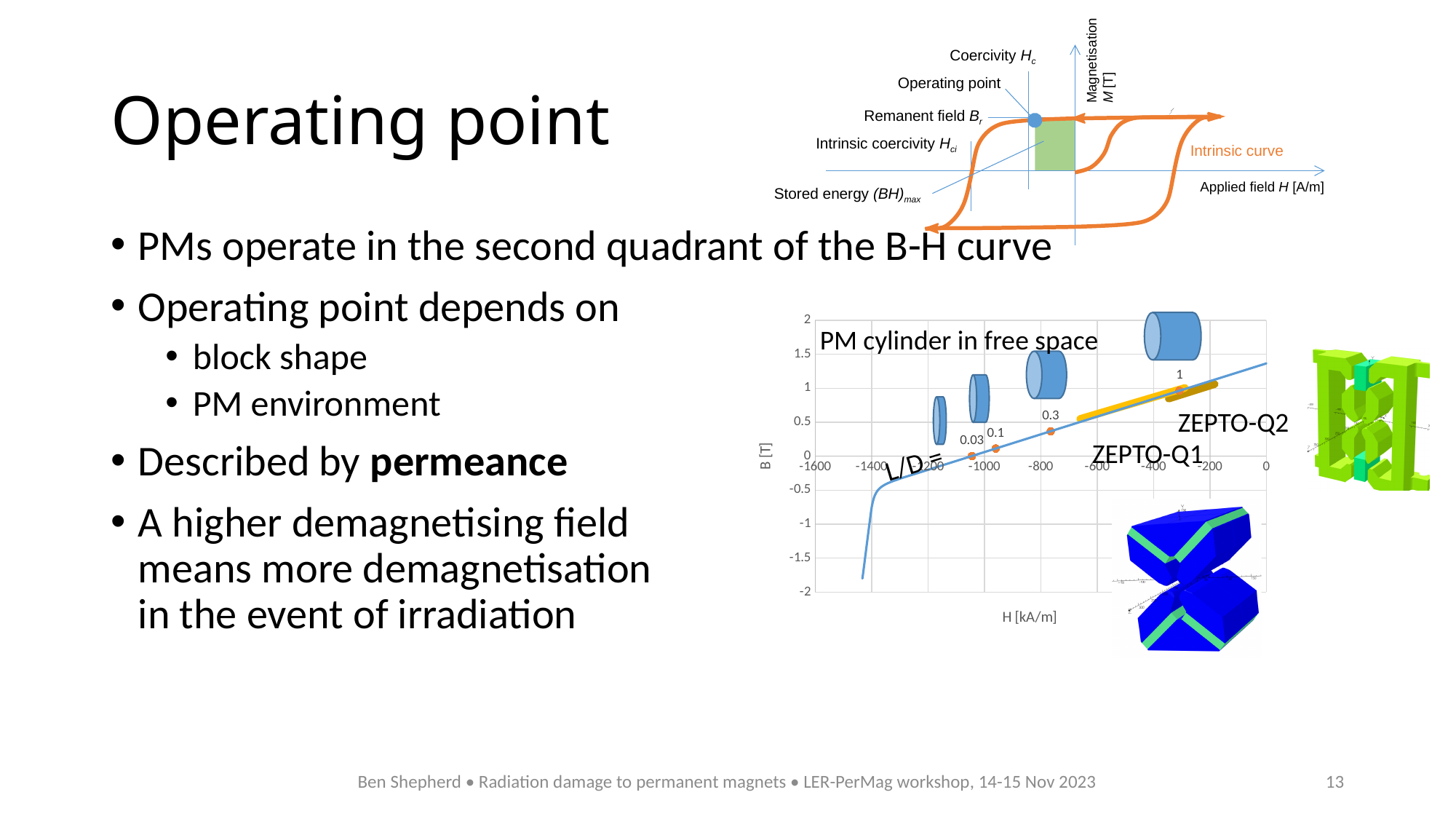
What kind of chart is the 'PM cylinder in free space' chart? line chart In the 'PM cylinder in free space' chart, what is the lowest value shown on the H axis? -1600 In the 'PM cylinder in free space' chart, does B rise or fall as H increases from -1600 toward 0 kA/m? rise In the 'PM cylinder in free space' chart, is the B value for the L/D = 0.3 point greater or less than 1? less In the top-right hysteresis diagram, what is the label of the horizontal axis? Applied field H [A/m] In the 'PM cylinder in free space' chart, which operates at a higher B value, ZEPTO-Q1 or ZEPTO-Q2? ZEPTO-Q2 In the 'PM cylinder in free space' chart, how many L/D values are labelled on the plotted points? 4 In the 'PM cylinder in free space' chart, which labelled L/D point has the highest B value? 1 In the 'PM cylinder in free space' chart, is the B value for the L/D = 1 point greater or less than 0.5? greater In the 'PM cylinder in free space' chart, which has the higher B value, the L/D = 1 point or the L/D = 0.03 point? L/D = 1 Which two magnets are labelled on the 'PM cylinder in free space' chart? ZEPTO-Q1 and ZEPTO-Q2 In the 'PM cylinder in free space' chart, which labelled L/D point has the lowest B value? 0.03